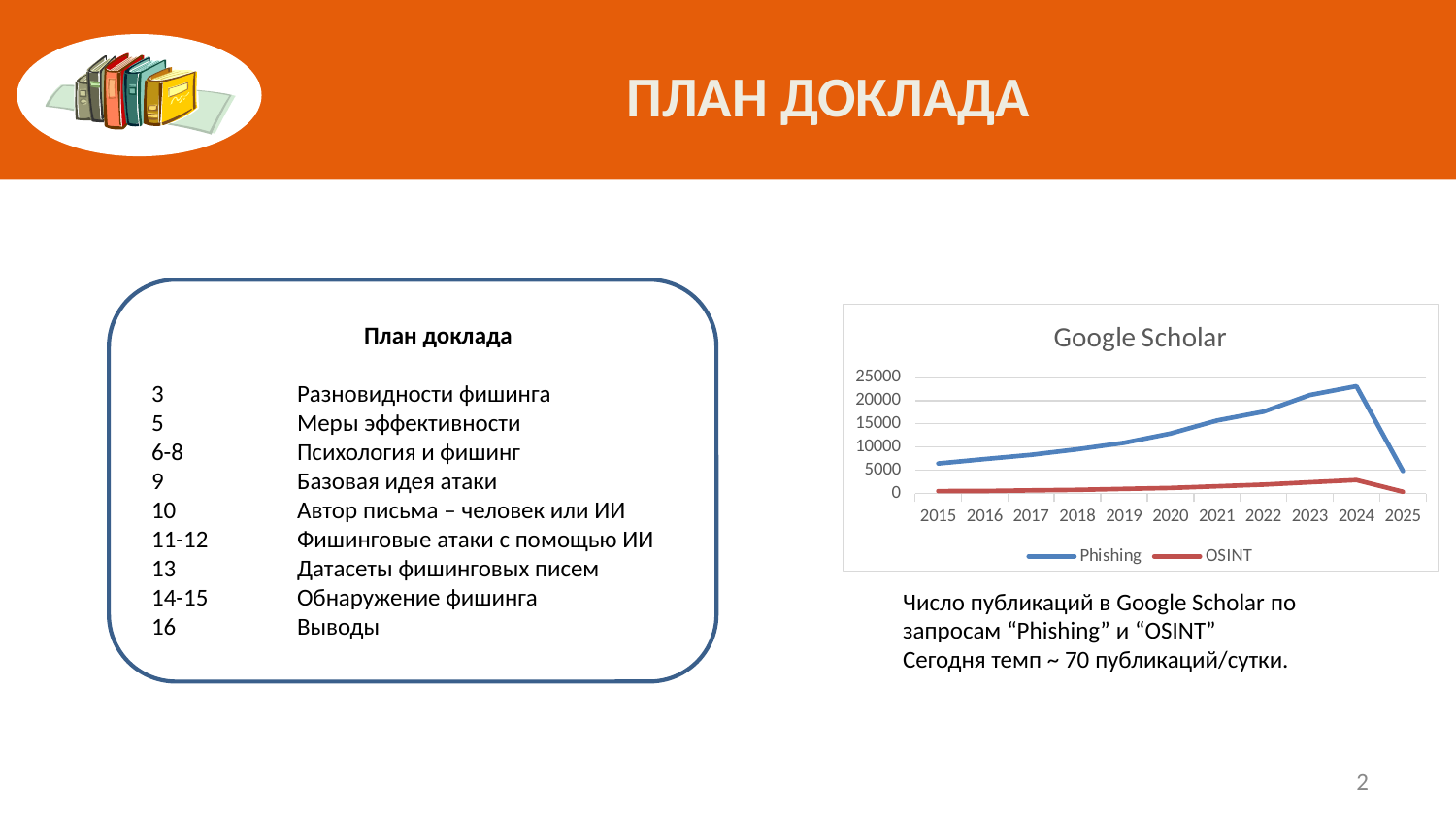
What kind of chart is shown on the slide? line chart How many series does the chart's legend list? 2 Which series are listed in the chart's legend? Phishing and OSINT Is the value for Phishing in 2024 greater or less than 20000? greater Does the Phishing series rise or fall from 2024 to 2025? fall Is the value for OSINT in 2024 greater or less than 5000? less Does the Phishing series rise or fall from 2015 to 2024? rise How many years are shown along the x axis of the chart? 11 In which year does the Phishing series reach its highest value? 2024 What is the title of the chart? Google Scholar Is the value for Phishing in 2020 greater or less than 10000? greater Which series has the larger value in 2023, Phishing or OSINT? Phishing